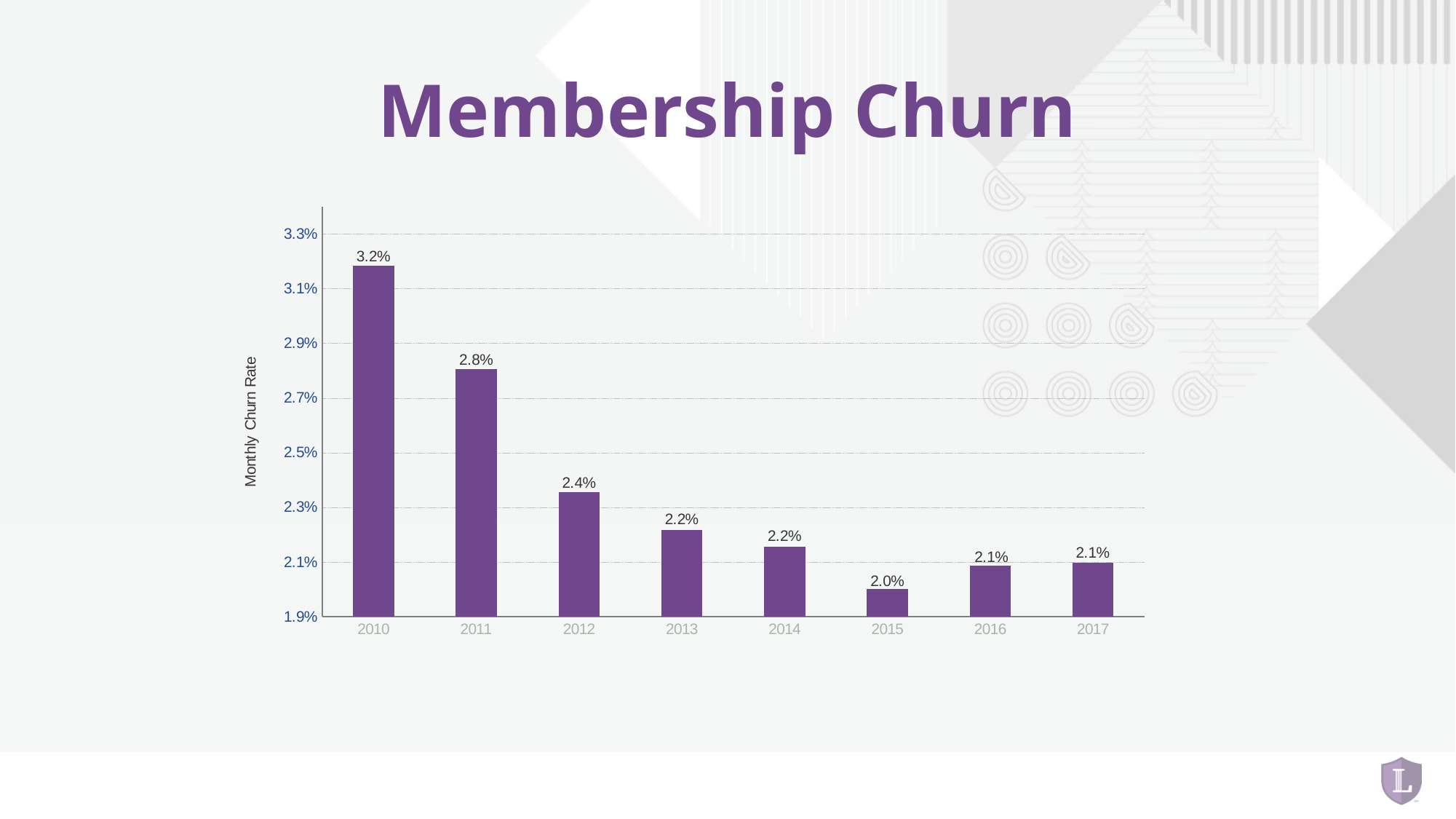
What is the monthly churn rate for 2015? 2.0% How many years are shown on the x axis? 8 Which year has the lowest monthly churn rate? 2015 What is the monthly churn rate for 2017? 2.1% What is the label of the vertical axis? Monthly Churn Rate What is the difference between the churn rate in 2010 and in 2011? 0.4% What kind of chart is shown on the slide? Bar chart What is the monthly churn rate for 2010? 3.2% Which year has a higher churn rate, 2011 or 2012? 2011 Is the value for 2012 greater or less than 2.3%? greater Which year has the highest monthly churn rate? 2010 What is the monthly churn rate for 2012? 2.4%